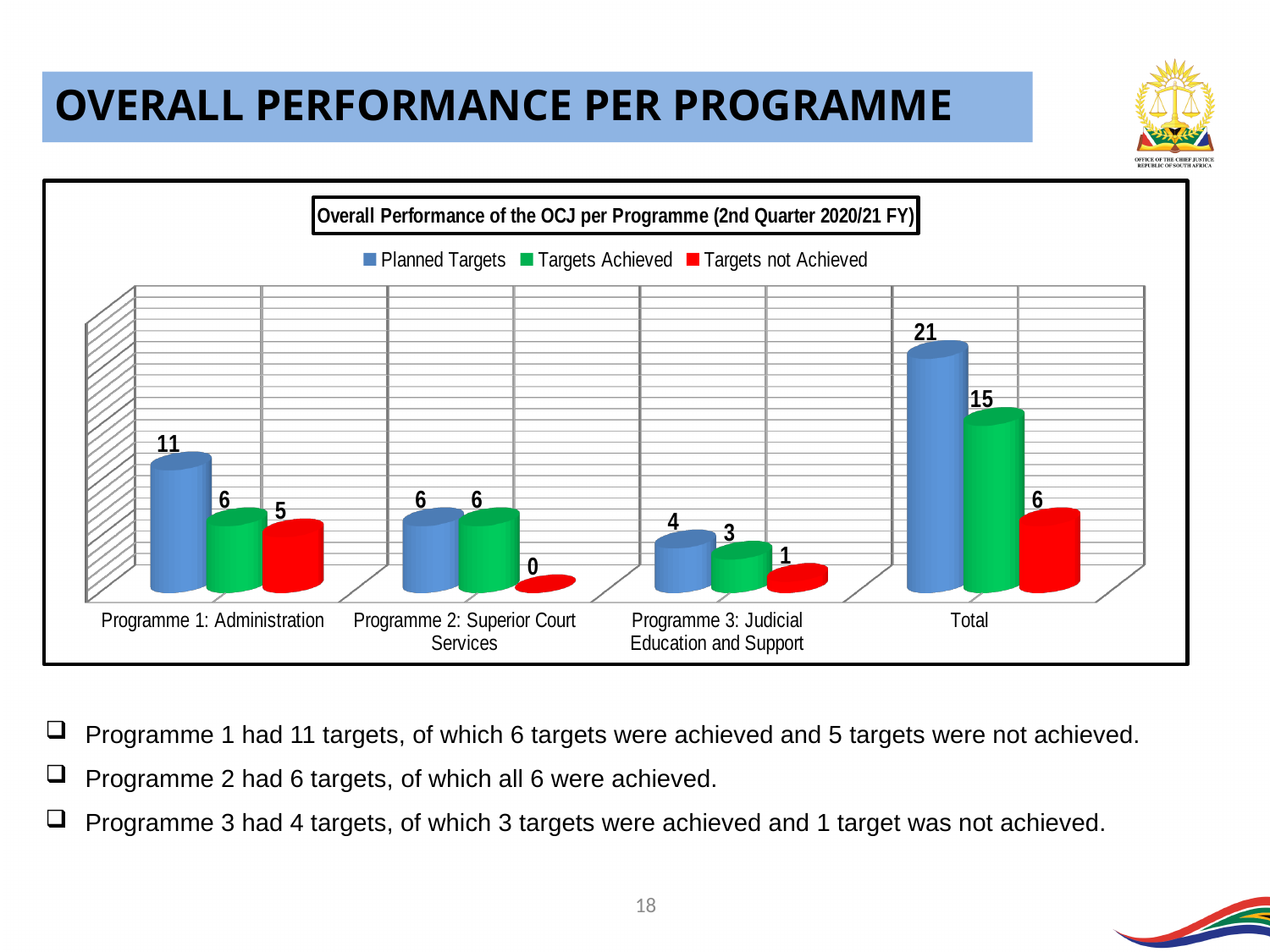
Which category has the highest Planned Targets value? Total Among the three programmes (excluding Total), which has the lowest Planned Targets value? Programme 3: Judicial Education and Support How many categories are shown on the x axis? 4 What kind of chart is shown on the slide? Bar chart Which is larger for Programme 3: Judicial Education and Support, Targets Achieved or Targets not Achieved? Targets Achieved What is the value of Targets Achieved for Programme 3: Judicial Education and Support? 3 What is the value of Targets not Achieved for Programme 2: Superior Court Services? 0 What is the title of the chart? Overall Performance of the OCJ per Programme (2nd Quarter 2020/21 FY) What is the value of Targets Achieved for Total? 15 What is the value of Planned Targets for Programme 1: Administration? 11 How many series does the legend list? 3 What is the difference between Planned Targets and Targets Achieved for Programme 1: Administration? 5